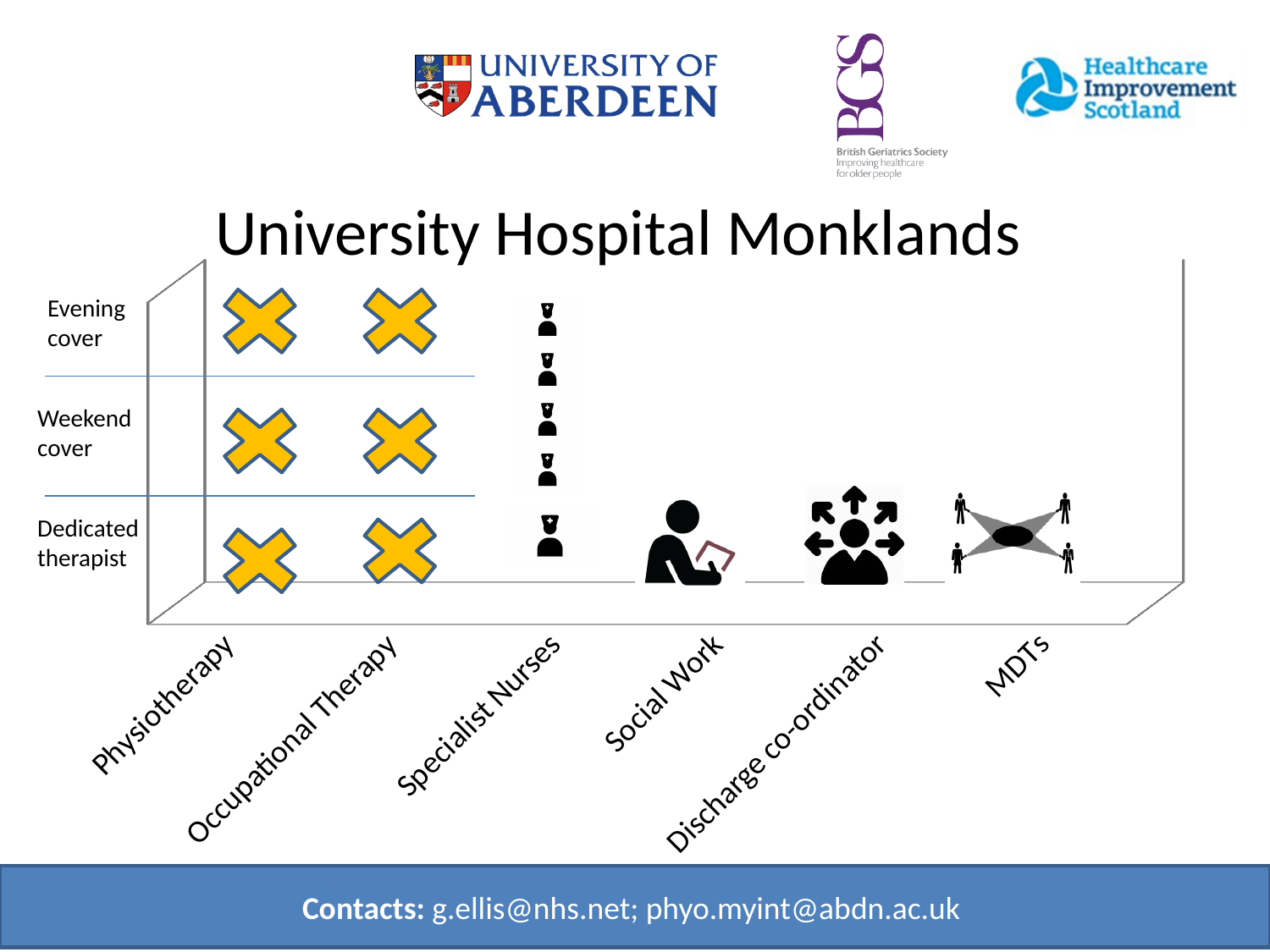
How many categories are shown along the x axis of the chart? 6 Does the Social Work column reach above the Dedicated therapist level? No Which category is furthest to the left on the x axis? Physiotherapy Which category has the tallest stack of icons, reaching the Evening cover level? Specialist Nurses How many nurse icons are stacked in the Specialist Nurses column? 5 Which category is furthest to the right on the x axis? MDTs What is the label of the lowest level on the vertical axis? Dedicated therapist Which two categories are marked with yellow crosses at every level? Physiotherapy and Occupational Therapy How many levels are labelled on the vertical axis of the chart? 3 Which column is taller, Specialist Nurses or Discharge co-ordinator? Specialist Nurses How many yellow cross marks appear on the chart in total? 6 What is the title of the chart? University Hospital Monklands